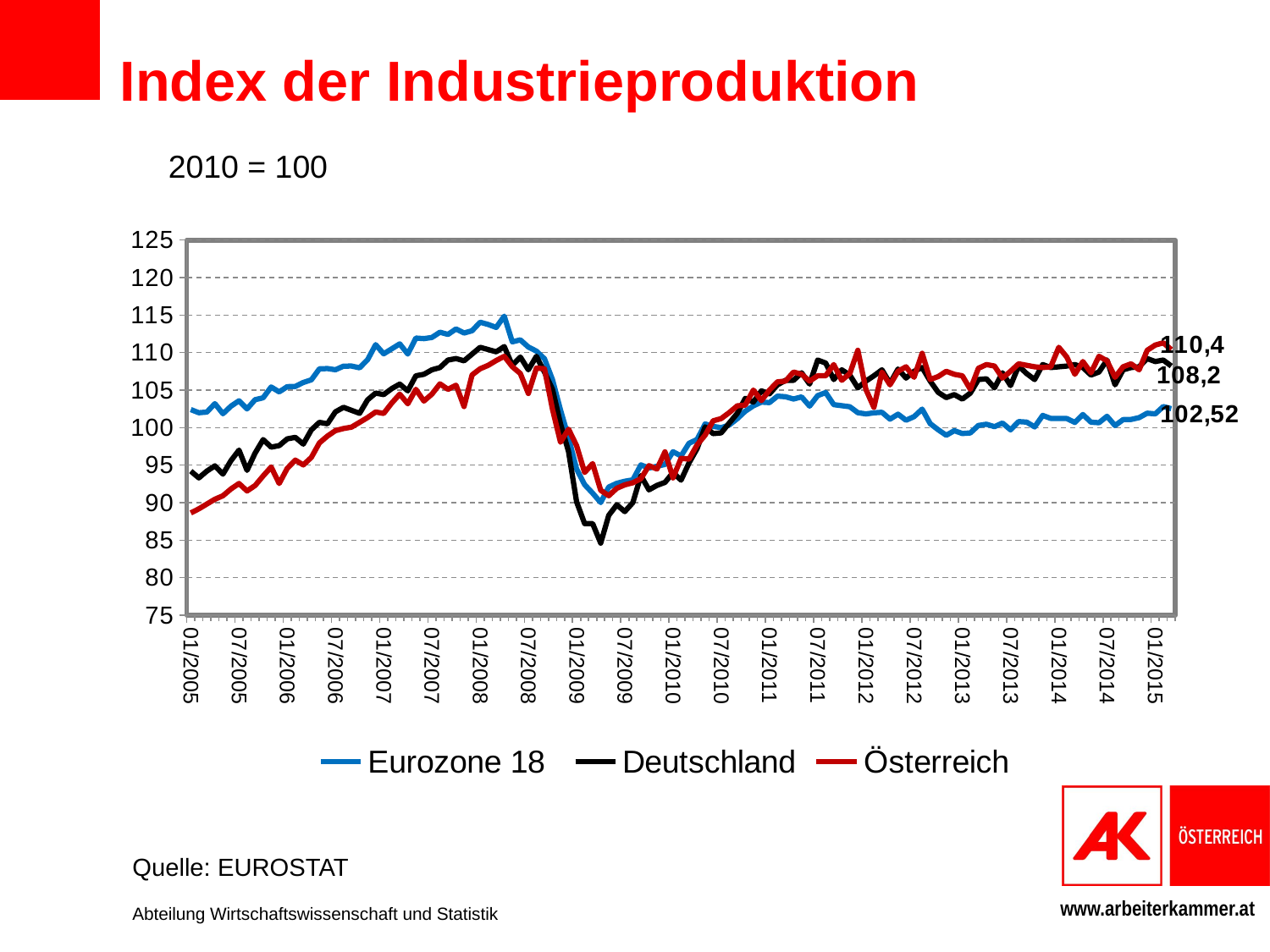
How many series does the legend list? 3 Which series has the lowest labelled value at the end of the chart? Eurozone 18 Is the value for Österreich at 01/2005 greater or less than 90? less What kind of chart is shown on the slide? line chart At the end of the chart, which is larger: the value for Österreich or the value for Eurozone 18? Österreich What is the final labelled value for Deutschland? 108,2 Which series has the highest labelled value at the end of the chart? Österreich What is the difference between the final labelled values of Deutschland and Eurozone 18? 5,68 What is the difference between the final labelled values of Österreich and Deutschland? 2,2 What is the final labelled value for Österreich? 110,4 What is the source given for the chart data? EUROSTAT What is the final labelled value for Eurozone 18? 102,52